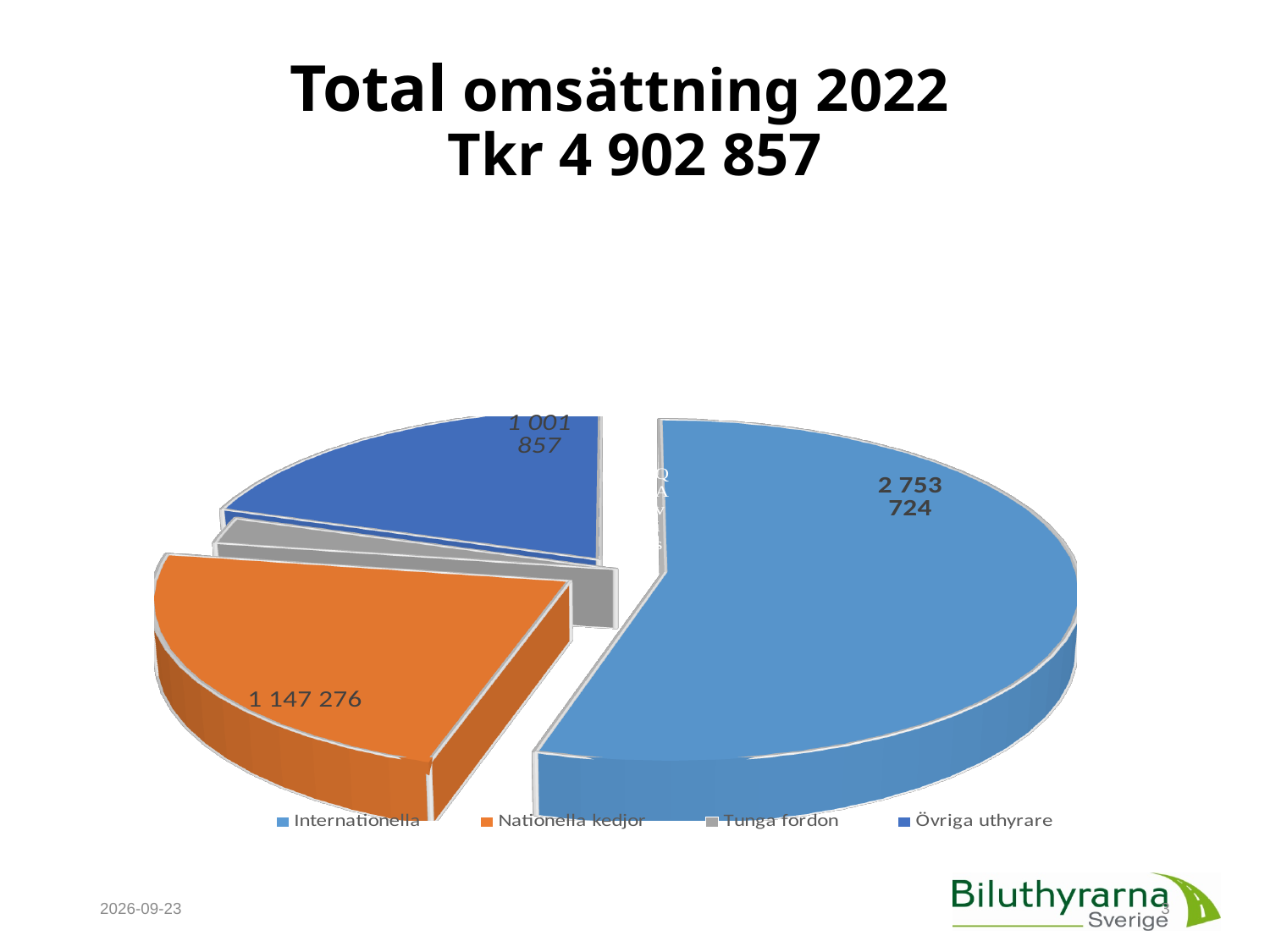
Which category has the largest slice of the pie? Internationella What is the value for Nationella kedjor? 1 147 276 What kind of chart is shown on the slide? pie chart What is the title of the slide? Total omsättning 2022 Tkr 4 902 857 What is the difference between the values for Nationella kedjor and Övriga uthyrare? 145 419 What colour is the Nationella kedjor slice? orange What is the value for Övriga uthyrare? 1 001 857 Which is larger, Nationella kedjor or Övriga uthyrare? Nationella kedjor What is the difference between the values for Internationella and Nationella kedjor? 1 606 448 What is the value for Internationella? 2 753 724 How many categories does the legend list? 4